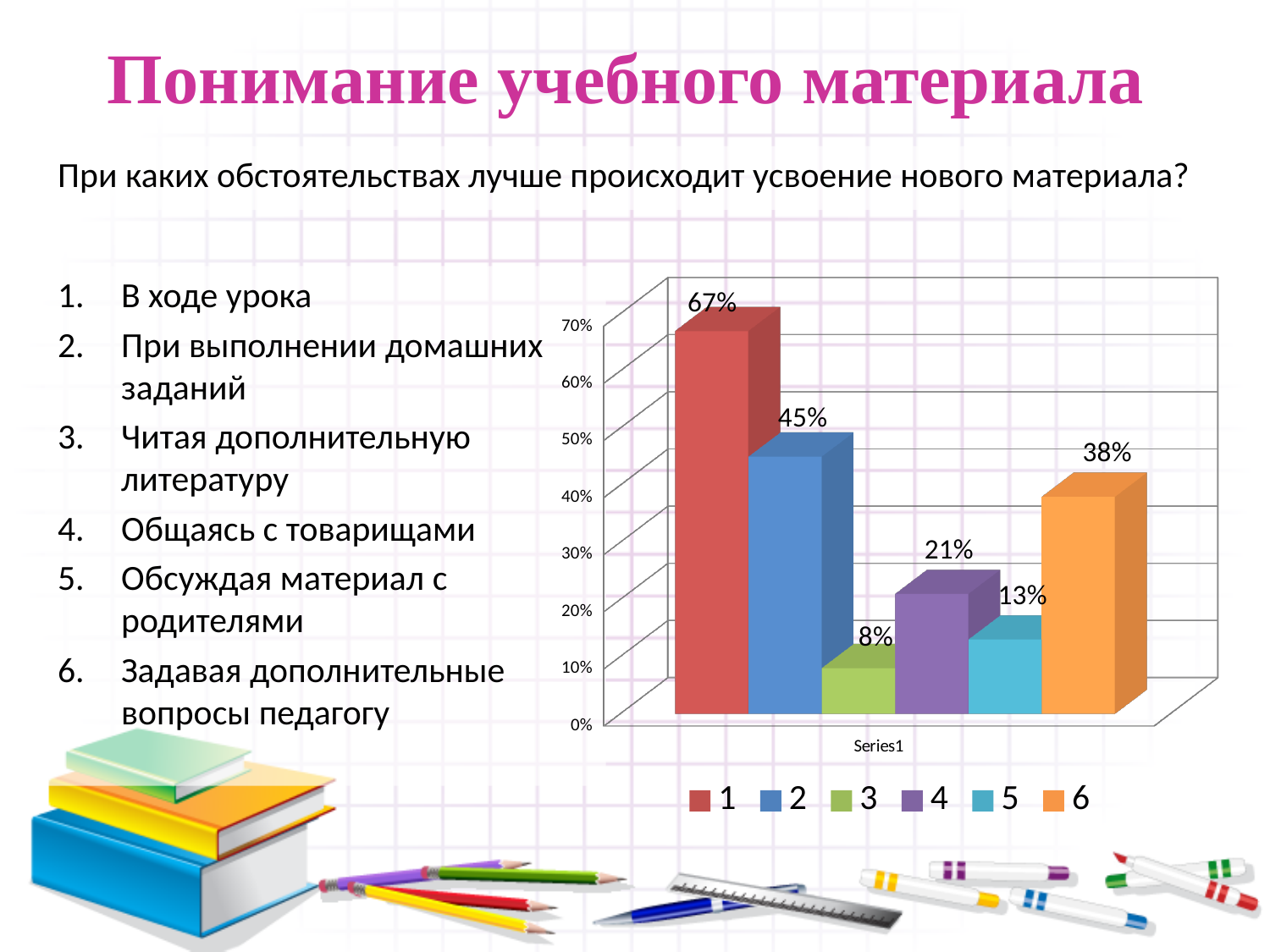
What value is shown for series 4 in the chart? 21% Which series has the lowest value in the chart? 3 What value is shown for series 6 in the chart? 38% What is the label shown on the x axis of the chart? Series1 What kind of chart is shown on the slide? bar chart What value is shown for series 1 in the chart? 67% Which is larger, the value for series 4 or the value for series 5? 4 What is the difference between the values for series 1 and series 2? 22% Which series has the highest value in the chart? 1 How many series does the legend list? 6 What is the difference between the values for series 6 and series 5? 25% What value is shown for series 2 in the chart? 45%